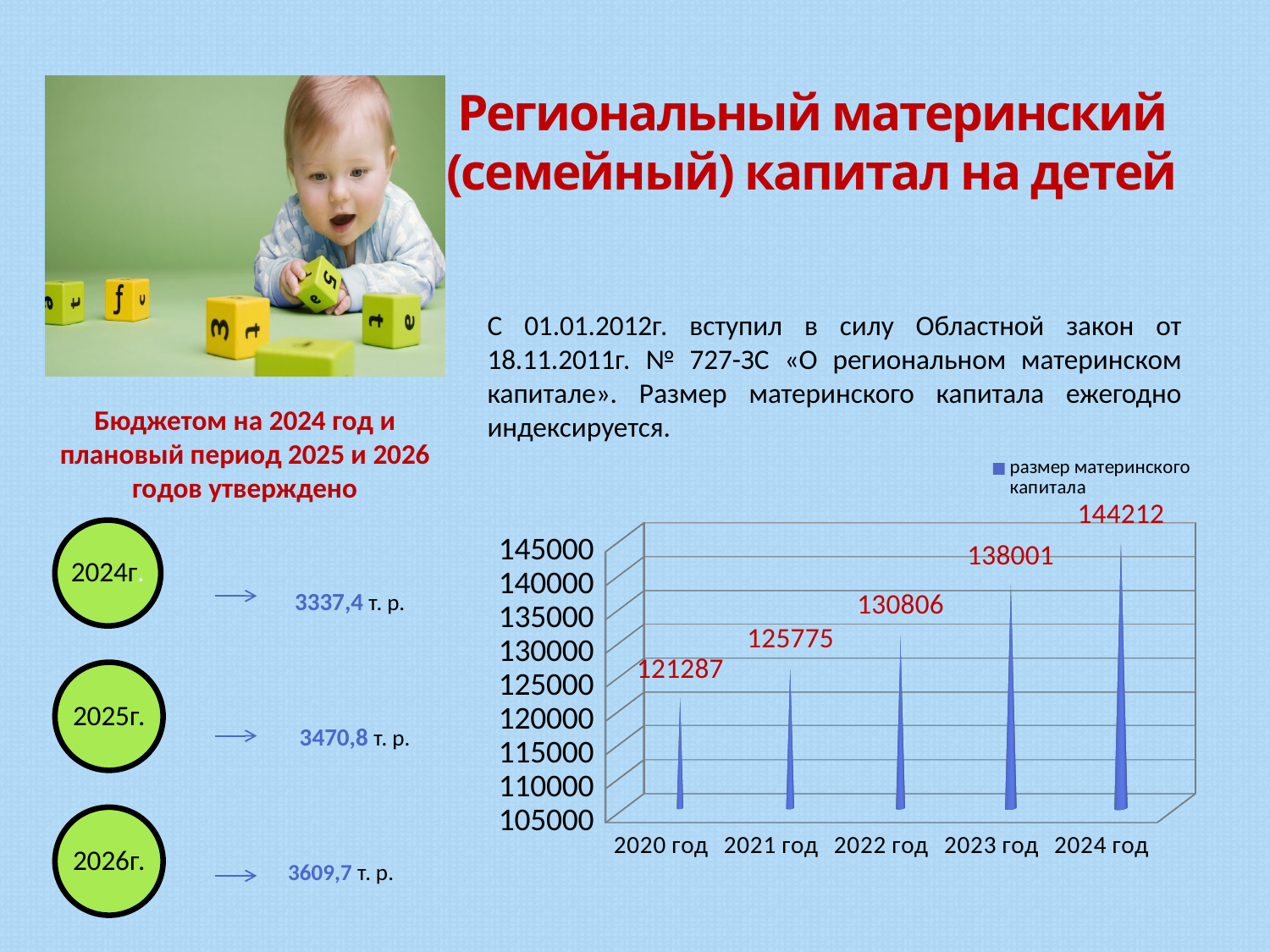
Which year has the highest value? 2024 год What is the difference between the values for 2021 год and 2020 год? 4488 What is the value for 2022 год? 130806 Do the values rise or fall from 2020 год to 2024 год? rise What is the value for 2024 год? 144212 How many years are shown on the x axis? 5 Which is larger, the value for 2021 год or the value for 2023 год? 2023 год Which year has the lowest value? 2020 год What is the difference between the values for 2024 год and 2023 год? 6211 What is the value for 2020 год? 121287 What series name does the legend show? размер материнского капитала Is the value for 2022 год greater or less than 125000? greater